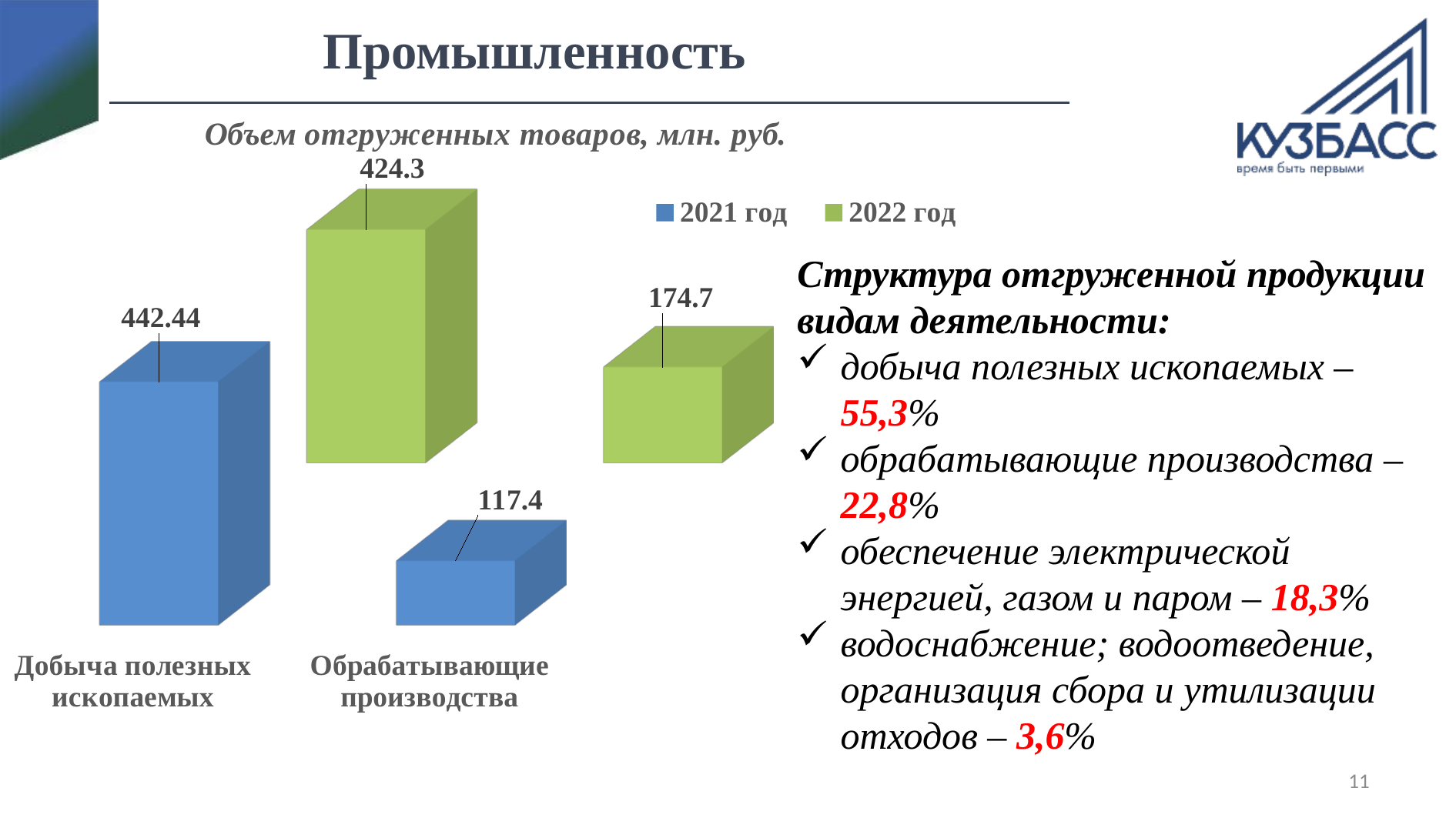
How many categories are shown on the x axis of the chart? 2 What is the title of the chart? Объем отгруженных товаров, млн. руб. Which is larger for Обрабатывающие производства: the 2021 год value or the 2022 год value? 2022 год Which category has the lowest value in the 2021 год series? Обрабатывающие производства How many series does the chart legend list? 2 Which category has the highest value in the 2022 год series? Добыча полезных ископаемых What is the value for Добыча полезных ископаемых in 2021 год? 442.44 What is the value for Обрабатывающие производства in 2022 год? 174.7 What is the difference between the 2021 год and 2022 год values for Добыча полезных ископаемых? 18.14 What is the value for Обрабатывающие производства in 2021 год? 117.4 What is the difference between the 2022 год and 2021 год values for Обрабатывающие производства? 57.3 What is the value for Добыча полезных ископаемых in 2022 год? 424.3